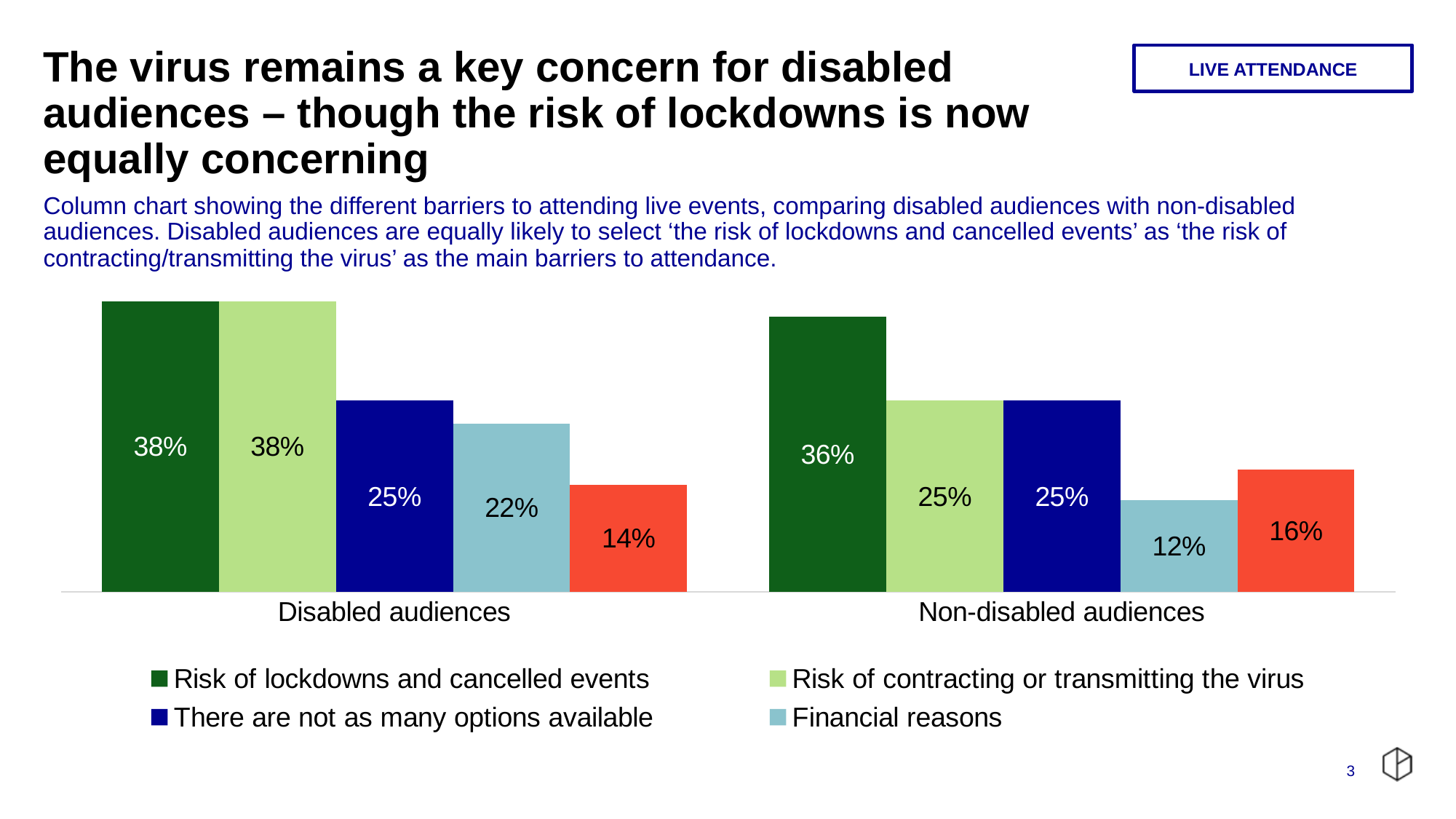
Which barrier has the highest value for non-disabled audiences? Risk of lockdowns and cancelled events What kind of chart is shown on the slide? Bar chart What percentage of disabled audiences selected 'Risk of lockdowns and cancelled events' as a barrier? 38% What is the value for 'Risk of contracting or transmitting the virus' among non-disabled audiences? 25% Which barrier has the lowest value for non-disabled audiences? Financial reasons How many series does the legend list? 4 What is the difference between disabled and non-disabled audiences for 'Financial reasons'? 10 percentage points How many audience groups are shown on the x axis? 2 What is the difference between disabled and non-disabled audiences for 'Risk of lockdowns and cancelled events'? 2 percentage points What is the value for 'Financial reasons' among non-disabled audiences? 12% What is the value for 'There are not as many options available' among disabled audiences? 25% Which group has the higher value for 'Risk of contracting or transmitting the virus', disabled audiences or non-disabled audiences? Disabled audiences